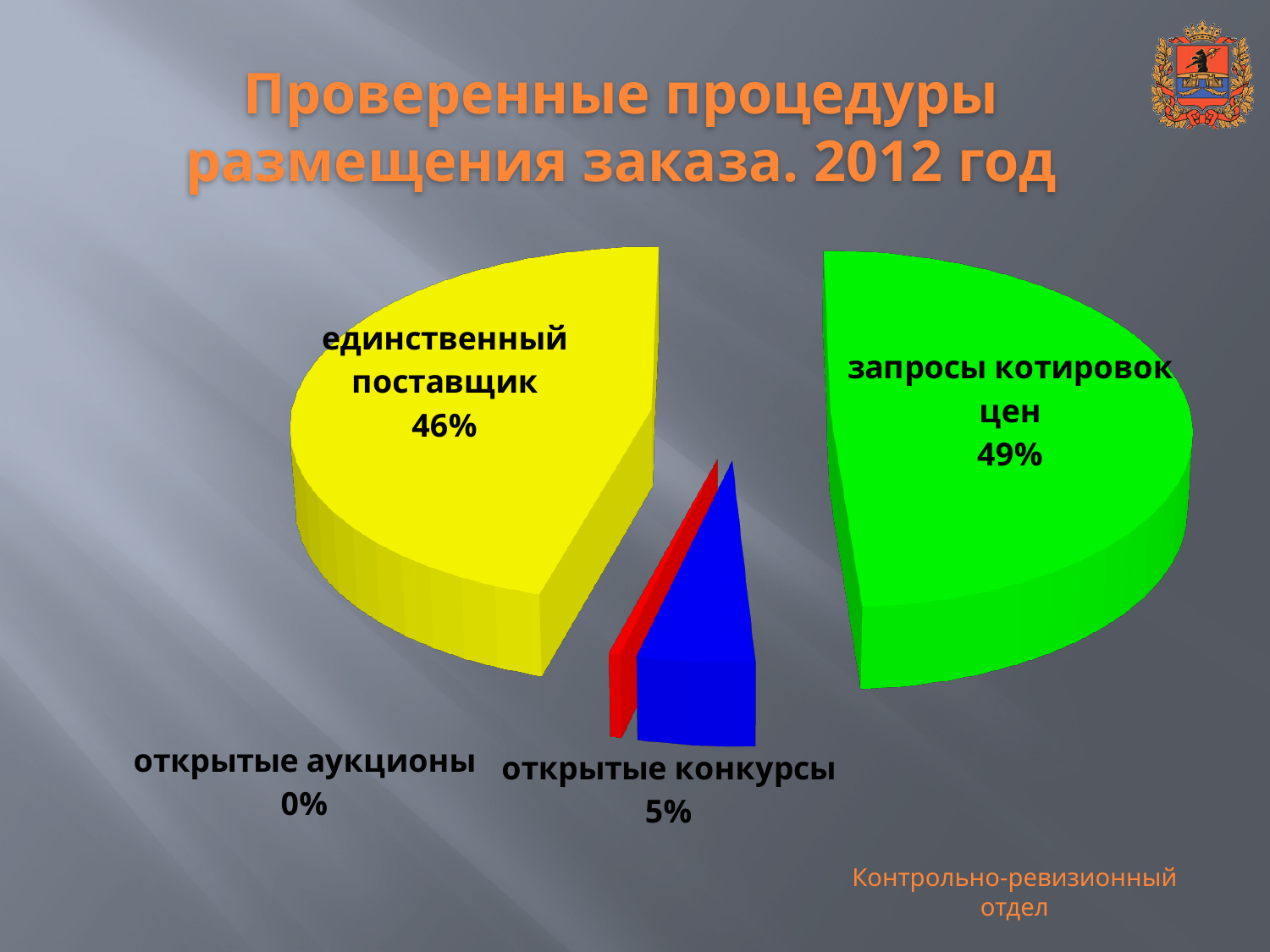
What share of the pie does "открытые конкурсы" have? 5% Which is larger: the share for "открытые конкурсы" or the share for "открытые аукционы"? открытые конкурсы What share of the pie does "открытые аукционы" have? 0% Which category has the smallest share of the pie? открытые аукционы What is the title of the slide containing the chart? Проверенные процедуры размещения заказа. 2012 год How many categories are shown in the pie chart? 4 What share of the pie does "единственный поставщик" have? 46% What kind of chart is shown on the slide? pie chart What is the difference in percentage points between "единственный поставщик" and "открытые конкурсы"? 41 What is the difference in percentage points between "запросы котировок цен" and "единственный поставщик"? 3 Which category has the largest share of the pie? запросы котировок цен